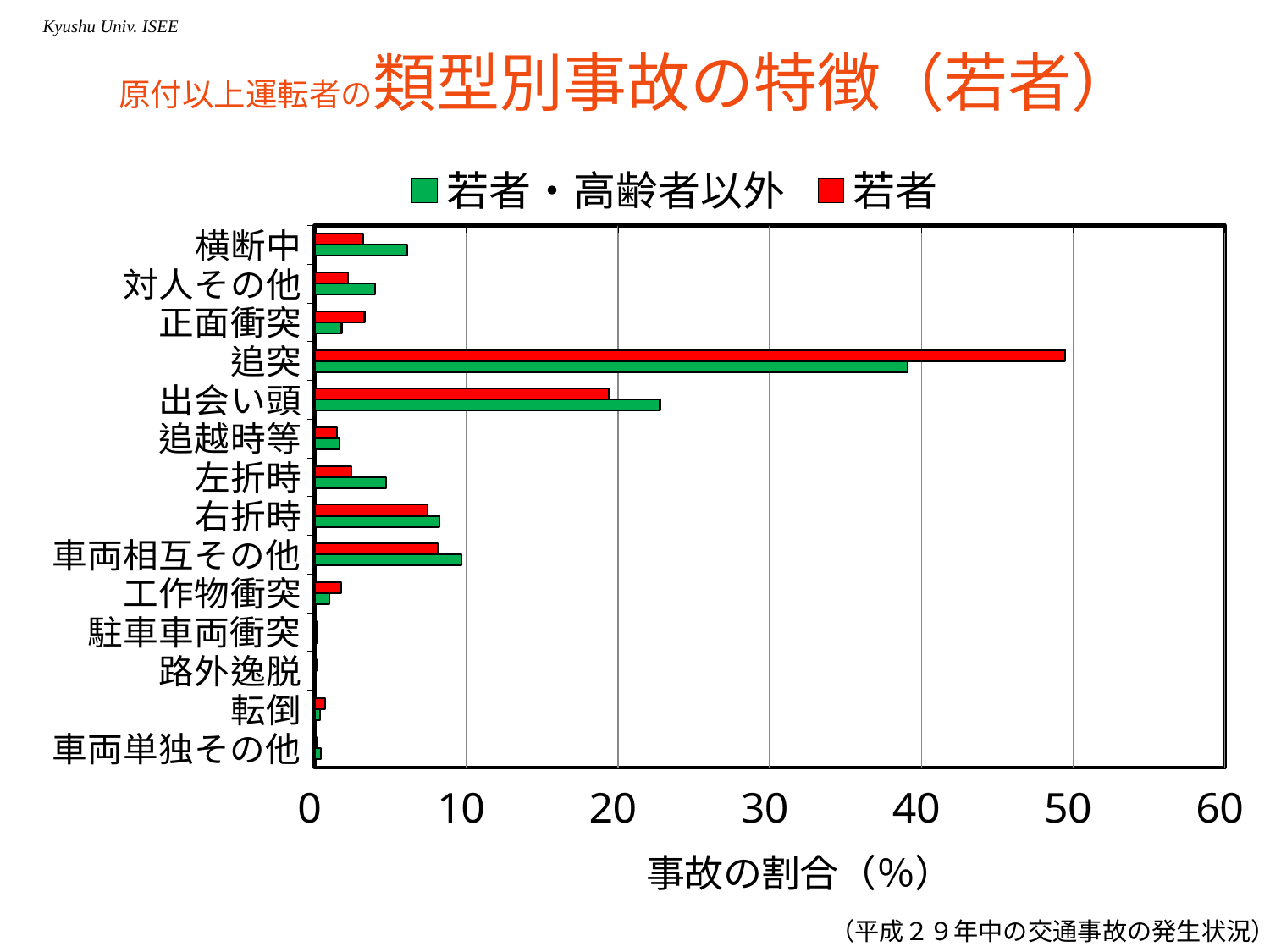
Is the 若者・高齢者以外 value for 出会い頭 greater or less than 20? greater What kind of chart is shown on the slide? bar chart How many series does the legend list? 2 How many accident categories are plotted on the y axis? 14 Which category has the highest value for the 若者・高齢者以外 series? 追突 For 出会い頭, which series has the larger value, 若者 or 若者・高齢者以外? 若者・高齢者以外 What colour represents the 若者 series in the legend? red Is the 若者 value for 出会い頭 greater or less than 20? less Is the 若者・高齢者以外 value for 追突 greater or less than 40? less For 追突, which series has the larger value, 若者 or 若者・高齢者以外? 若者 Which category has the highest value for the 若者 series? 追突